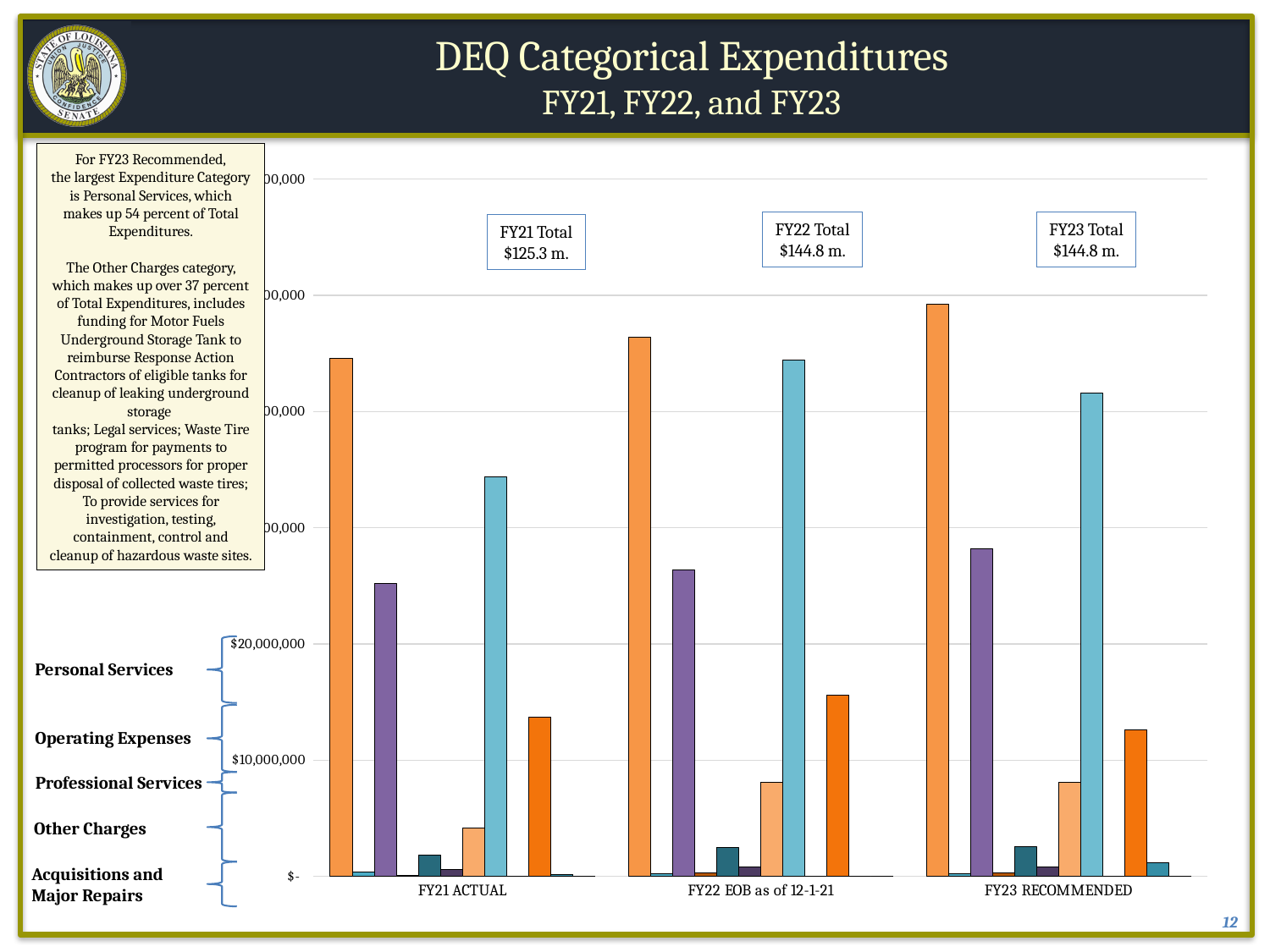
What is the FY23 Total shown on the chart? $144.8 m. Which fiscal year has the lowest total expenditures according to the total boxes on the chart? FY21 Is the value of the tallest (orange) bar in the FY23 RECOMMENDED group greater or less than $20,000,000? greater What is the difference between the FY22 Total and the FY21 Total shown on the chart? $19.5 m. How many fiscal-year groups are shown along the x axis of the chart? 3 What is the FY22 Total shown on the chart? $144.8 m. Which is taller: the light blue bar in the FY22 EOB as of 12-1-21 group or the light blue bar in the FY21 ACTUAL group? FY22 EOB as of 12-1-21 Does the tallest (orange) bar rise or fall from FY21 ACTUAL to FY23 RECOMMENDED? rise What is the x-axis label of the middle group of bars? FY22 EOB as of 12-1-21 What is the FY21 Total shown on the chart? $125.3 m. Is the value of the dark orange bar in the FY21 ACTUAL group greater or less than $10,000,000? greater What kind of chart is shown on the slide? bar chart